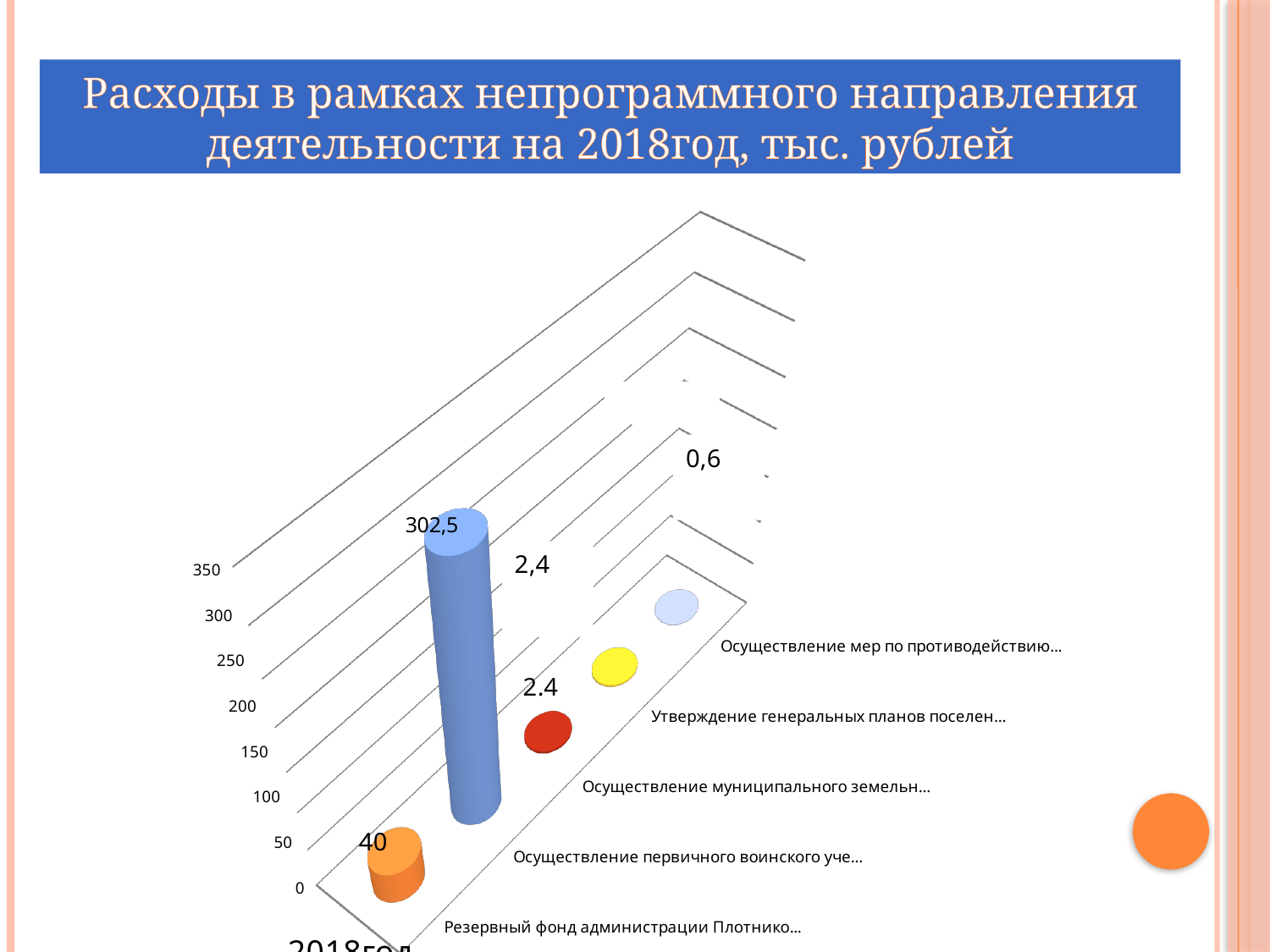
What is the difference between the values for Осуществление первичного воинского уче… and Резервный фонд администрации Плотнико…? 262,5 What is the value for Резервный фонд администрации Плотнико…? 40 Is the value for Осуществление первичного воинского уче… greater or less than 300? greater Which category has the highest value? Осуществление первичного воинского уче… How many categories are shown in the chart? 5 What kind of chart is shown on the slide? bar chart What is the value for Утверждение генеральных планов поселен…? 2,4 What is the title of the chart? Расходы в рамках непрограммного направления деятельности на 2018год, тыс. рублей Which is larger, the value for Резервный фонд администрации Плотнико… or the value for Осуществление муниципального земельн…? Резервный фонд администрации Плотнико… What is the value for Осуществление первичного воинского уче…? 302,5 Which category has the lowest value? Осуществление мер по противодействию… What is the value for Осуществление мер по противодействию…? 0,6